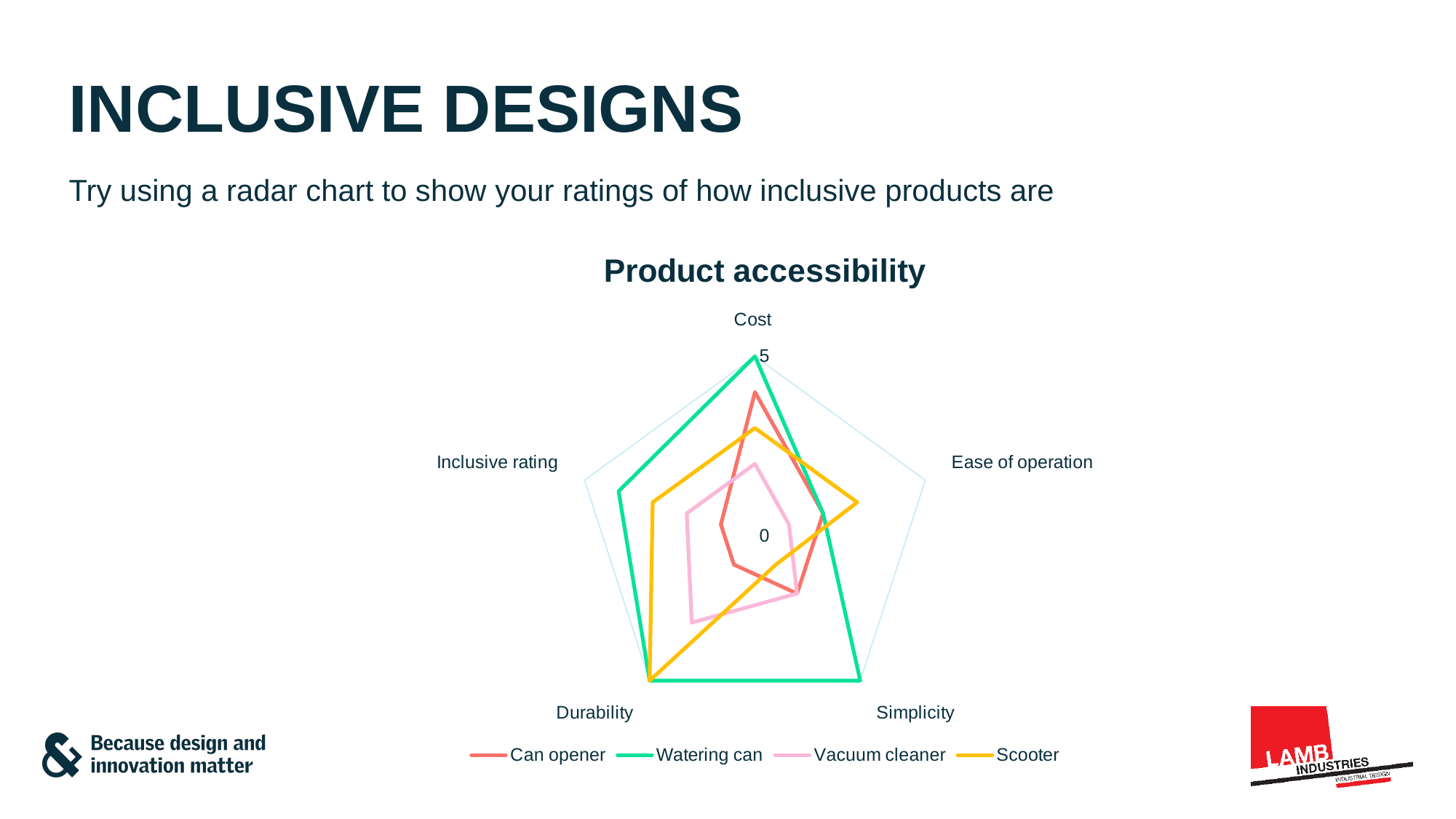
Which product has the highest Ease of operation rating? Scooter What is the Durability rating for Scooter? 5 What is the title of the chart? Product accessibility Which product has the lowest Durability rating? Can opener What kind of chart is shown on the slide? Radar chart How many categories (axes) does the radar chart have? 5 What is the Cost rating for Watering can? 5 What is the Simplicity rating for Watering can? 5 Which has the higher Cost rating, Watering can or Can opener? Watering can How many series does the legend list? 4 Which product has the highest Inclusive rating? Watering can Which product has the lowest Cost rating? Vacuum cleaner